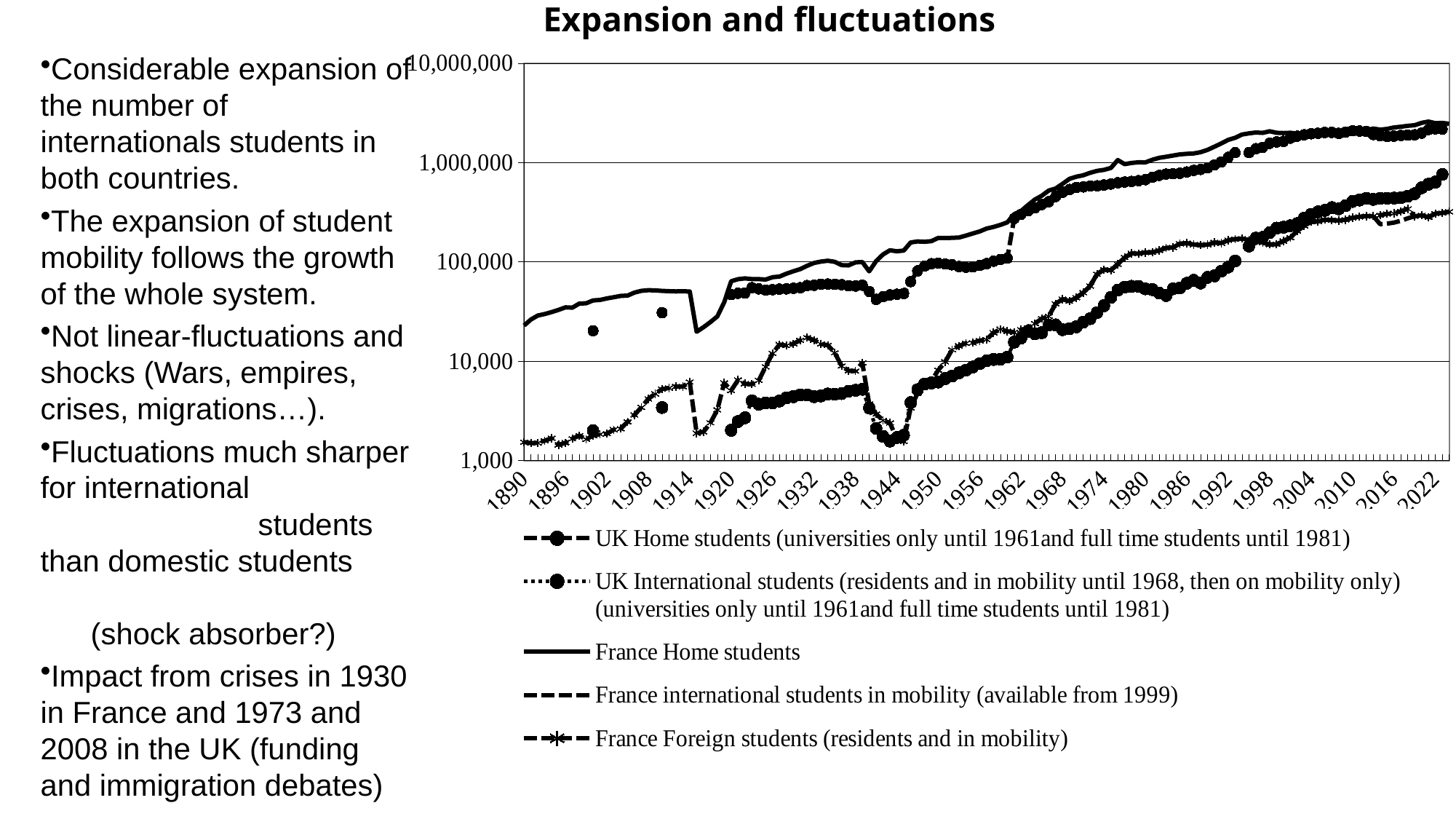
Is the value for UK International students in 2022 greater or less than 1,000,000? less What is the title of the chart? Expansion and fluctuations What is the highest value shown on the chart's y axis? 10,000,000 In 1890, which is larger: France Home students or France Foreign students (residents and in mobility)? France Home students Is the value for UK International students in 1944 greater or less than 10,000? less Is the value for France Home students in 1890 greater or less than 10,000? greater How many series does the chart legend list? 5 In 2022, which is larger: France Home students or UK International students? France Home students What kind of chart is shown on the slide? line chart Does the France Home students series rise or fall overall from 1890 to 2022? rise